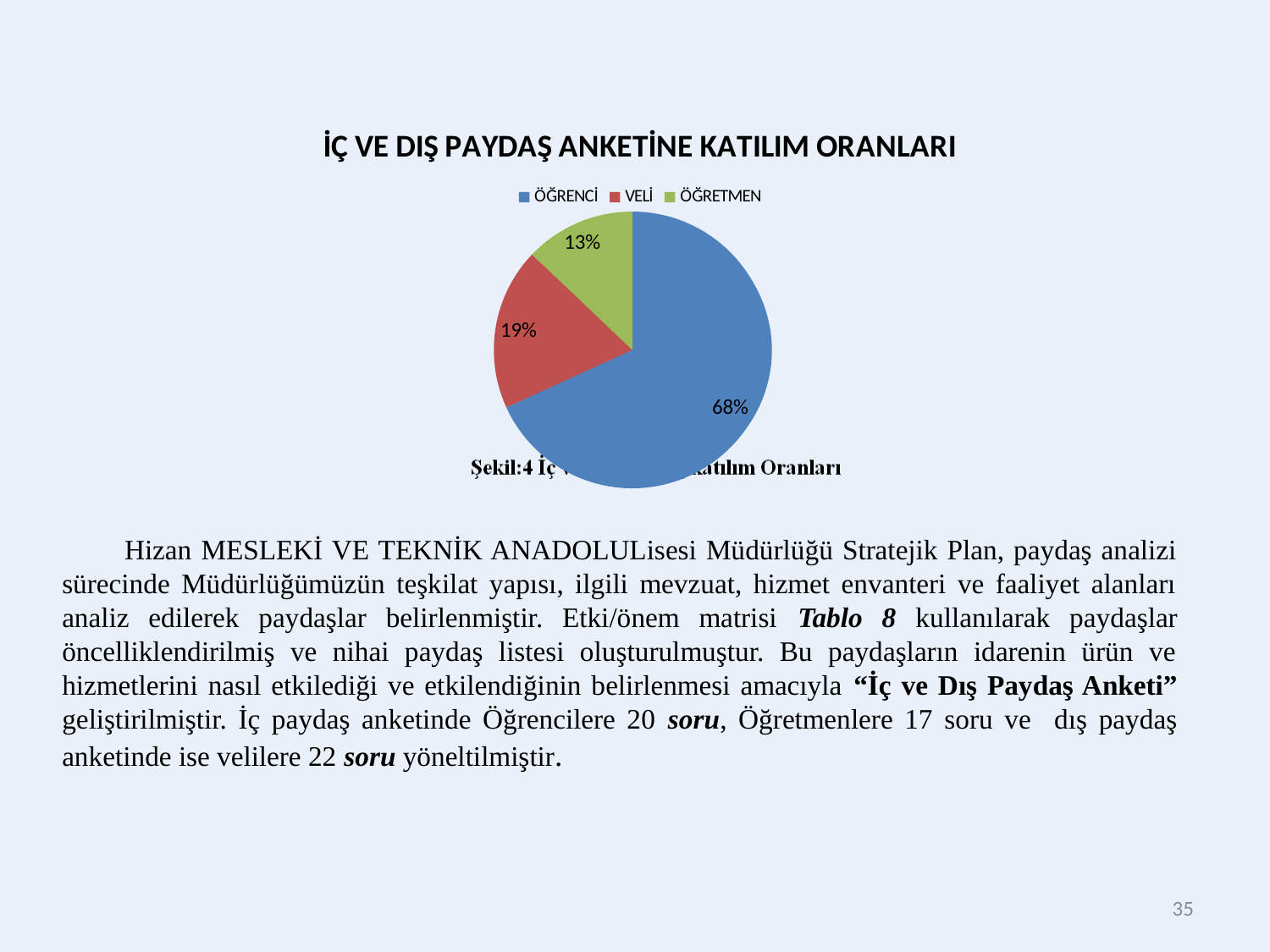
What kind of chart is shown on the slide? pie chart Which is larger, the VELİ slice or the ÖĞRETMEN slice? VELİ What is the difference in percentage points between the ÖĞRENCİ and VELİ slices? 49 What colour is the ÖĞRENCİ slice? blue What share of the pie does ÖĞRETMEN have? 13% What share of the pie does ÖĞRENCİ have? 68% What is the difference in percentage points between the VELİ and ÖĞRETMEN slices? 6 What is the title of the chart? İÇ VE DIŞ PAYDAŞ ANKETİNE KATILIM ORANLARI Which category has the largest slice of the pie? ÖĞRENCİ Which category has the smallest slice of the pie? ÖĞRETMEN How many categories does the legend list? 3 What share of the pie does VELİ have? 19%